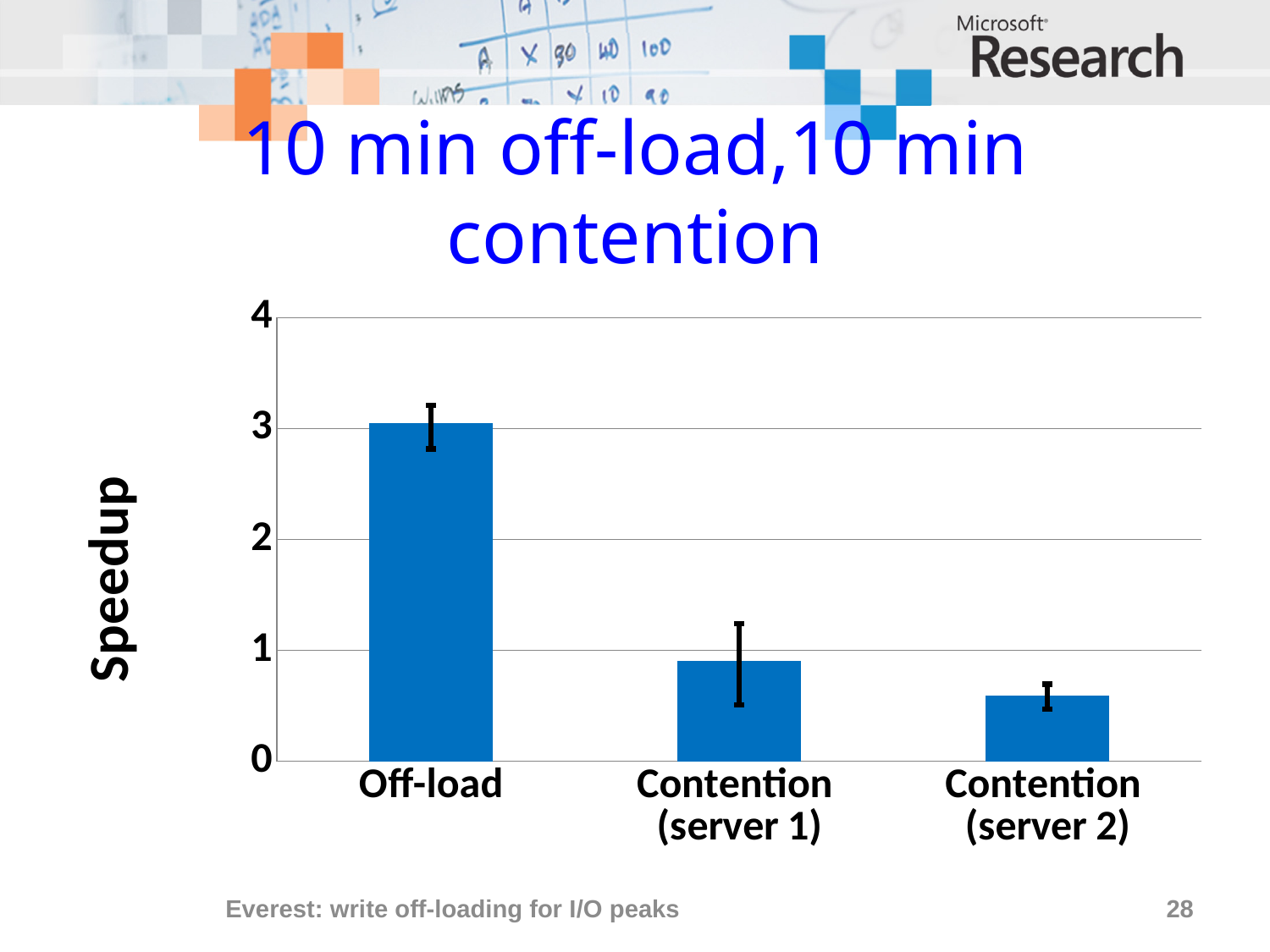
How many categories are plotted on the x axis of the chart? 3 Is the speedup for Contention (server 1) greater or less than 2? less Which category has the lowest speedup? Contention (server 2) What is the label on the y axis of the chart? Speedup Is the speedup for Off-load greater or less than 2? greater Which category has the highest speedup? Off-load Do the bar values rise or fall from left to right along the x axis? fall What kind of chart is shown on the slide? bar chart Which has the larger speedup, Contention (server 1) or Contention (server 2)? Contention (server 1) Is the speedup for Contention (server 2) greater or less than 1? less What is the highest value shown on the y axis of the chart? 4 Which has the larger speedup, Off-load or Contention (server 1)? Off-load